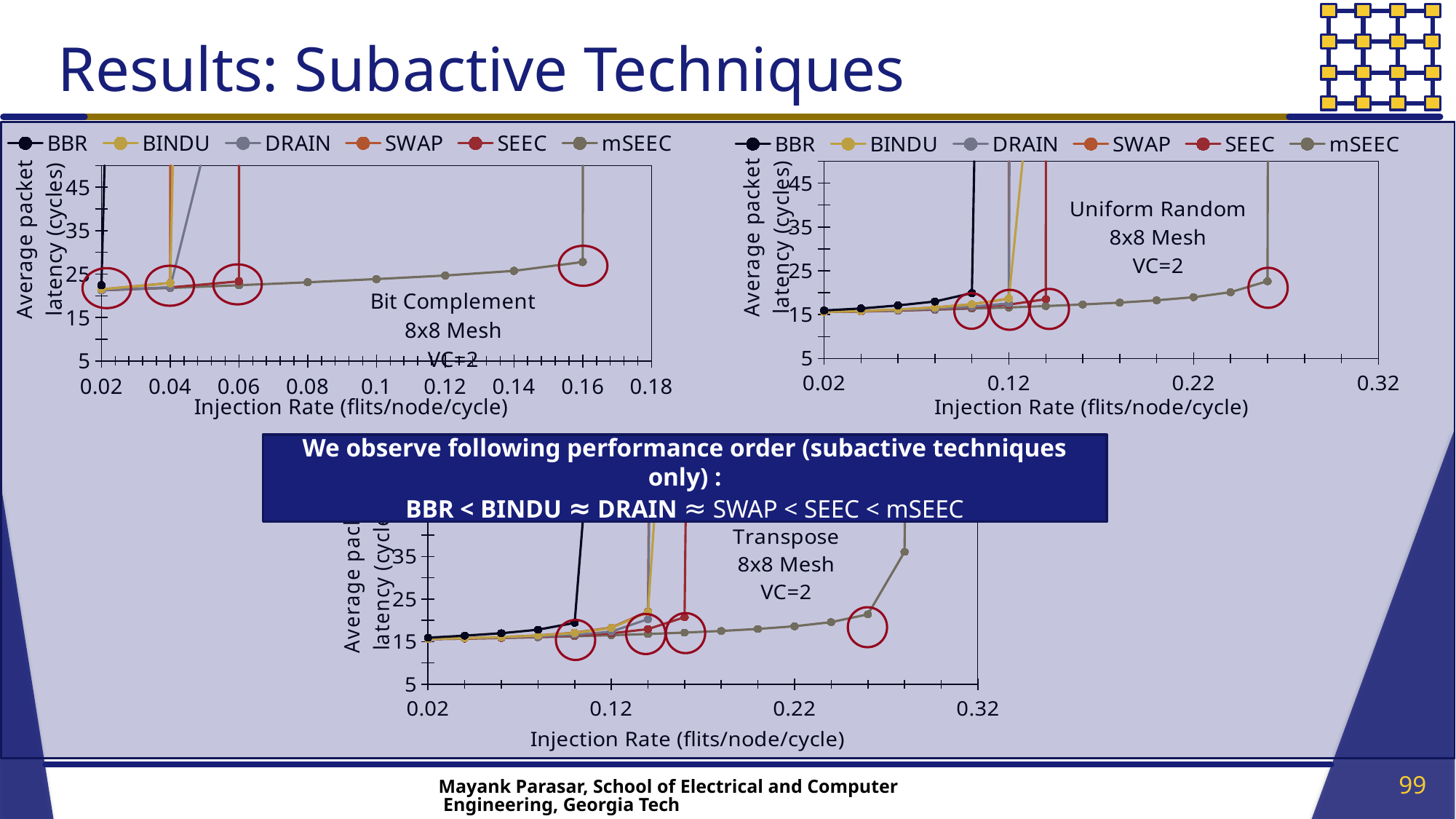
In the Uniform Random chart, which series sustains the highest injection rate before its latency shoots up? mSEEC In the Bit Complement chart, does the mSEEC latency rise or fall as the injection rate increases? rise In the Bit Complement chart, is the mSEEC latency at injection rate 0.02 greater or less than 25? less In the Transpose chart, which series saturates at a higher injection rate, BBR or SEEC? SEEC In the Uniform Random chart, is the mSEEC latency at injection rate 0.02 greater or less than 25? less What is the x-axis label of the Transpose chart? Injection Rate (flits/node/cycle) How many series does the legend of the Uniform Random chart list? 6 In the Transpose chart, is the BBR latency at injection rate 0.02 greater or less than 25? less In the Bit Complement chart, which series has its latency shoot up at the lowest injection rate? BBR What kind of chart is the Bit Complement chart? line chart Which series is listed first in the legend of the Bit Complement chart? BBR